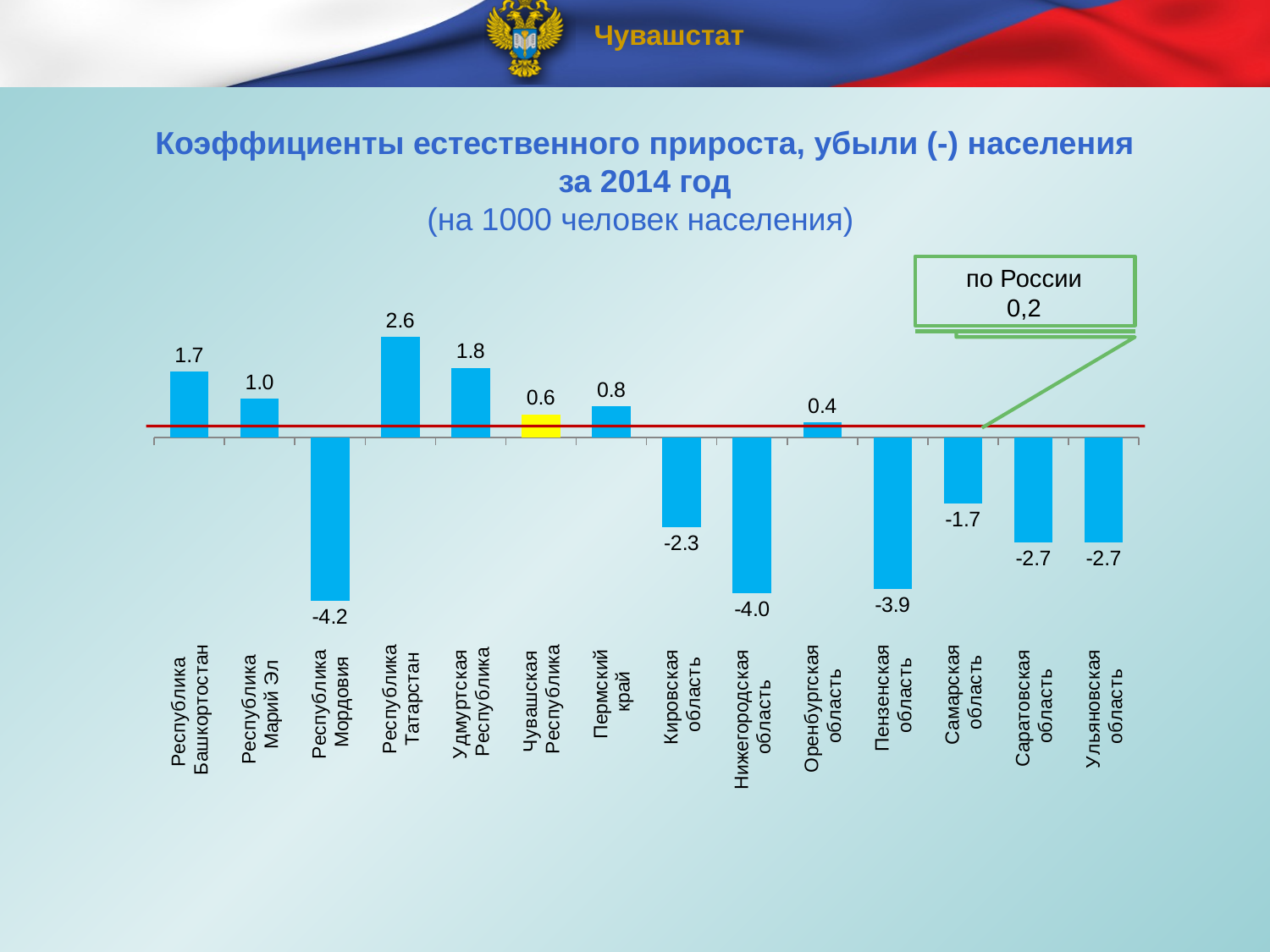
What is the value for Самарская область? -1.7 Which region has the highest value on the chart? Республика Татарстан Which is larger, the value for Пермский край or the value for Оренбургская область? Пермский край What is the value for Нижегородская область? -4.0 How many regions are shown on the chart? 14 Which region's bar is highlighted in yellow? Чувашская Республика What is the difference between the values for Республика Татарстан and Удмуртская Республика? 0.8 What kind of chart is shown on the slide? Bar chart Which region has the lowest value on the chart? Республика Мордовия What is the value for Республика Татарстан? 2.6 What value for Russia as a whole (по России) is shown in the callout box? 0,2 What is the value for Чувашская Республика? 0.6